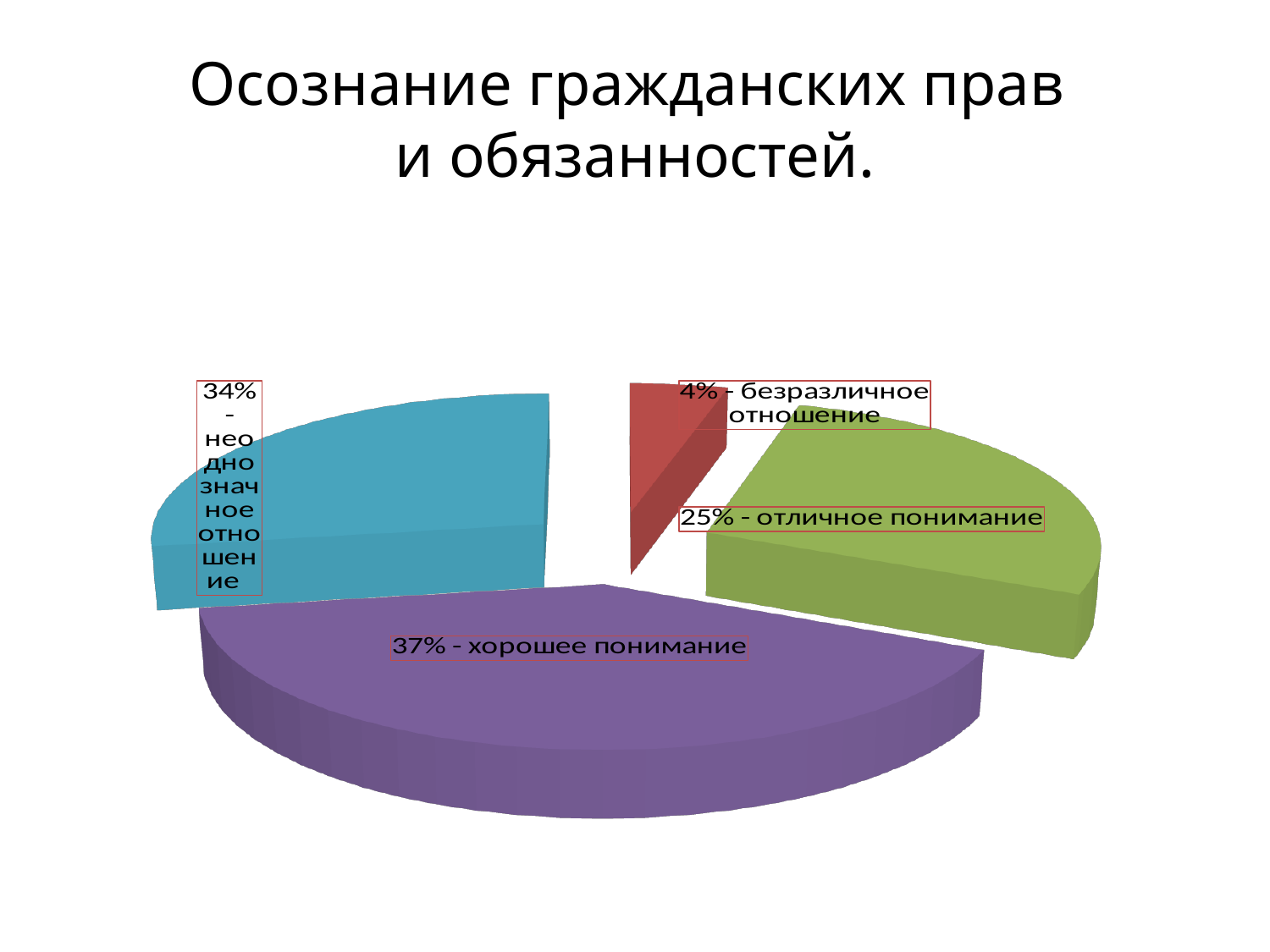
What colour is the slice for "хорошее понимание"? Purple What is the difference between the shares for "хорошее понимание" and "отличное понимание"? 12% Which is larger: the share for "неоднозначное отношение" or the share for "отличное понимание"? неоднозначное отношение What kind of chart is shown on the slide? Pie chart What share of the pie is labelled "хорошее понимание"? 37% What share of the pie is labelled "безразличное отношение"? 4% How many slices does the pie chart have? 4 What share of the pie is labelled "неоднозначное отношение"? 34% Which category has the smallest share of the pie? безразличное отношение Which category has the largest share of the pie? хорошее понимание What is the title of the slide containing the pie chart? Осознание гражданских прав и обязанностей.